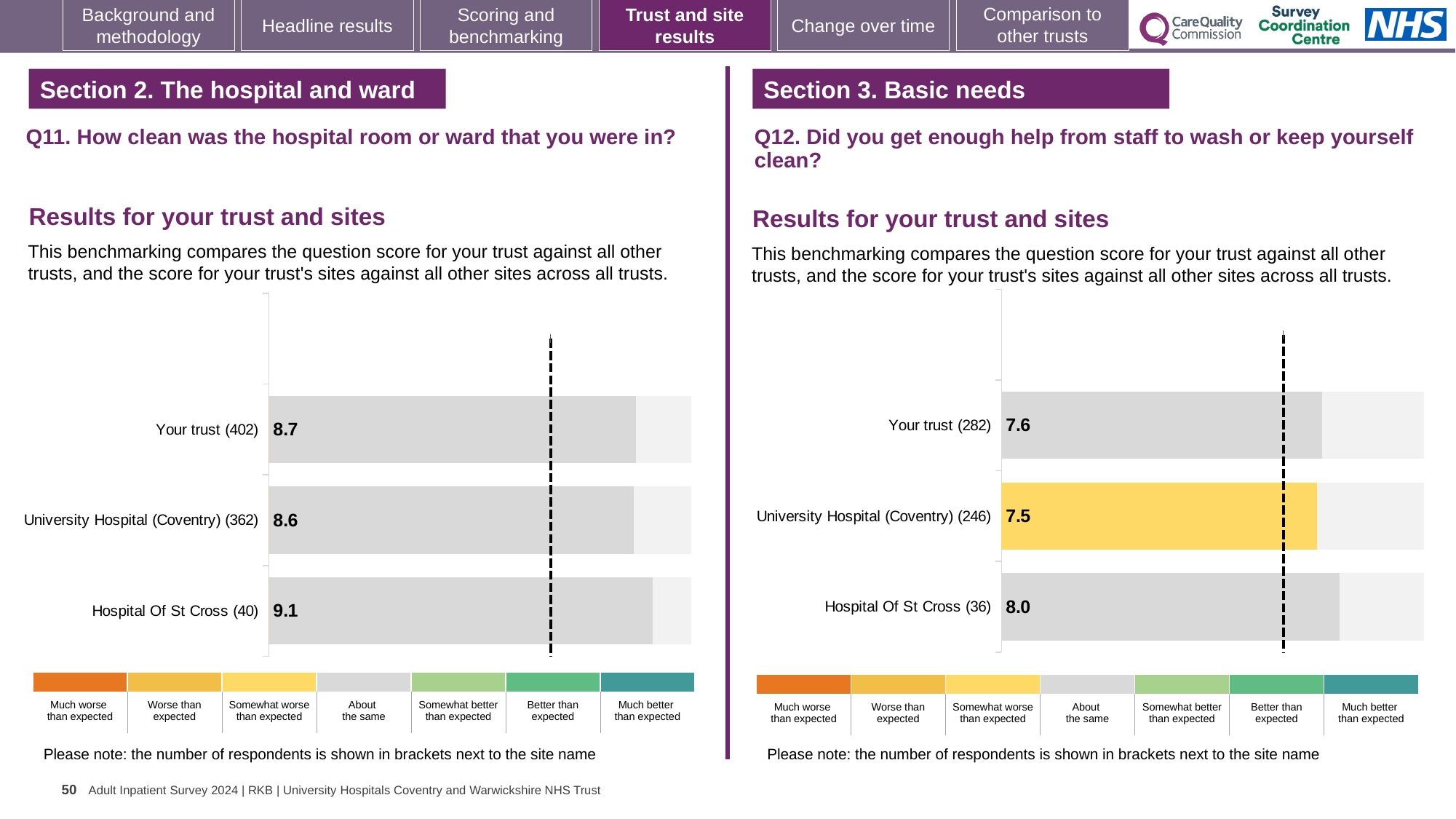
What kind of chart is used in the Q11 chart (left)? Bar chart In the Q11 chart (left), what is the difference between the scores for Hospital Of St Cross and University Hospital (Coventry)? 0.5 In the Q11 chart (left), how many bars are plotted? 3 In the Q11 chart (left), what is the score for Hospital Of St Cross? 9.1 In the Q11 chart (left), which site or trust has the highest score? Hospital Of St Cross In the Q12 chart (right), what is the score for Hospital Of St Cross? 8.0 In the Q12 chart (right), which has the larger score: Your trust or Hospital Of St Cross? Hospital Of St Cross In the Q12 chart (right), what is the difference between the scores for Hospital Of St Cross and Your trust? 0.4 In the Q12 chart (right), which site or trust has the lowest score? University Hospital (Coventry) In the Q12 chart (right), what is the score for University Hospital (Coventry)? 7.5 In the Q12 chart (right), which bar is coloured yellow, indicating 'Somewhat worse than expected'? University Hospital (Coventry) In the Q11 chart (left), what is the score for Your trust? 8.7